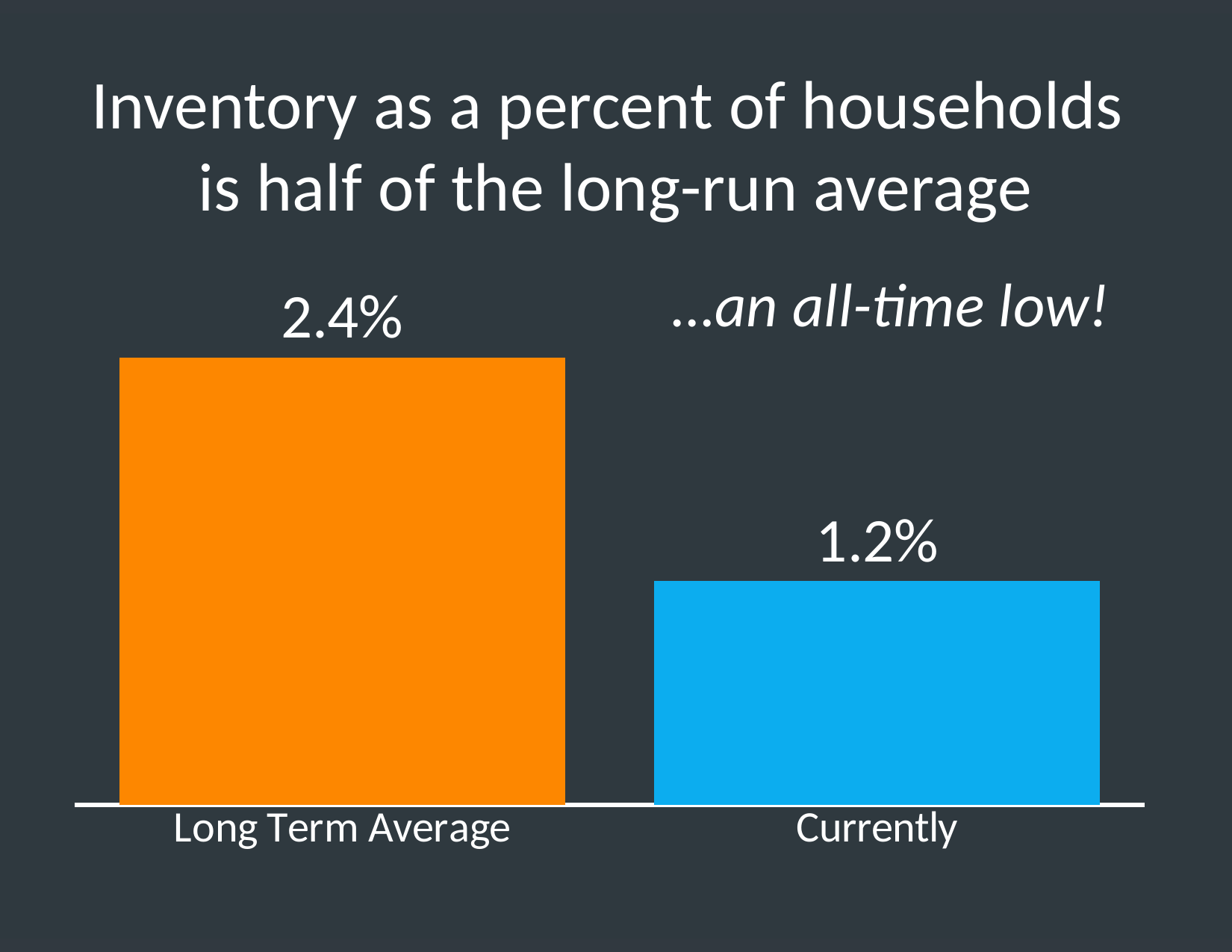
What is the value for Currently? 1.2% Which category has the highest value? Long Term Average What is the difference between the Long Term Average value and the Currently value? 1.2% Which is larger, the value for Long Term Average or the value for Currently? Long Term Average Do the values rise or fall from Long Term Average to Currently? Fall What is the value for Long Term Average? 2.4% How many categories are shown in the chart? 2 What colour is the bar for Long Term Average? Orange Which category has the lowest value? Currently What kind of chart is shown on the slide? Bar chart What colour is the bar for Currently? Blue